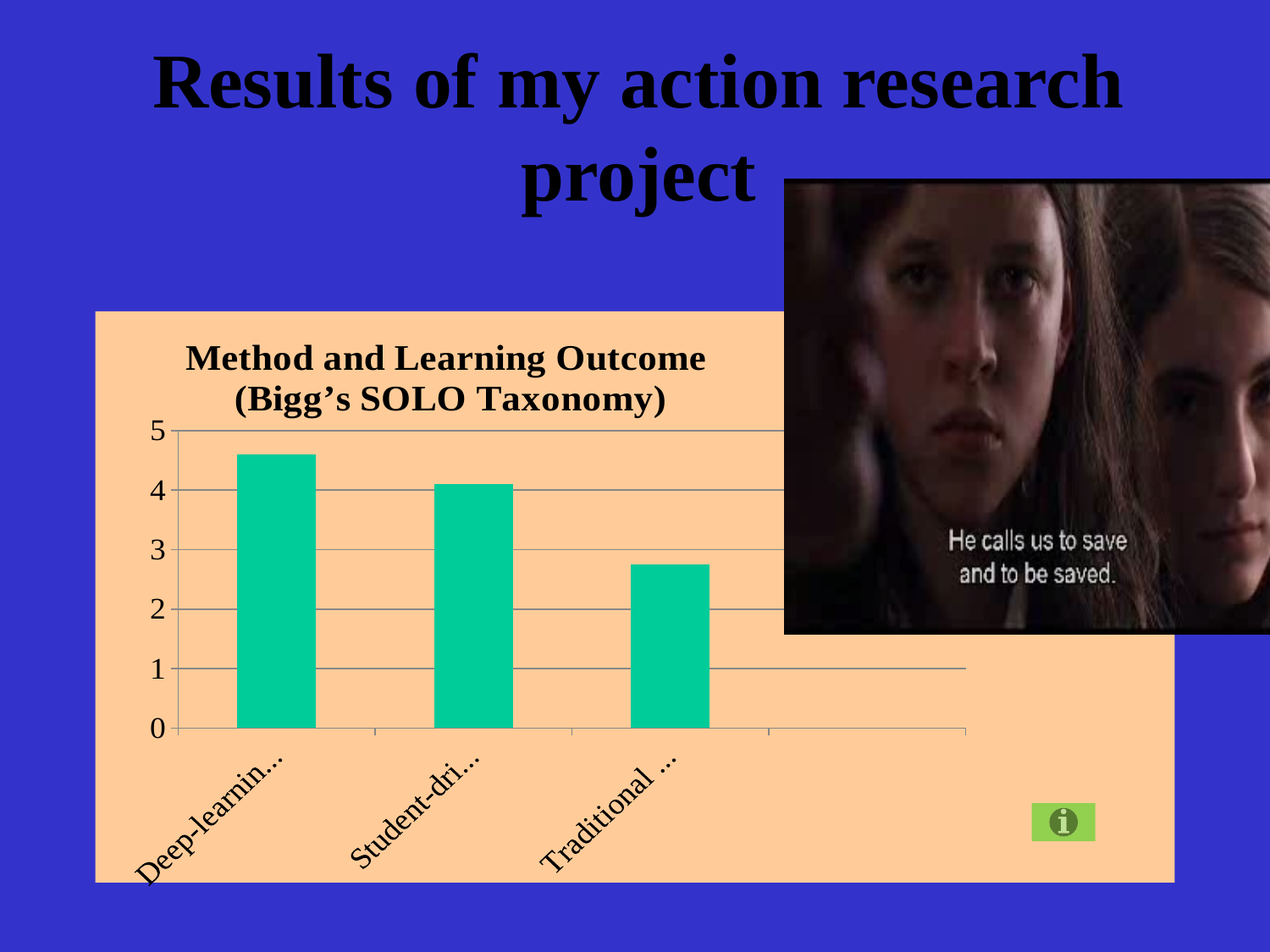
Which category has the highest bar? Deep-learnin... How many bars are plotted in the chart? 3 Which category has the lowest bar? Traditional ... Is the value for Traditional ... greater or less than 3? less What is the highest value shown on the vertical axis? 5 What is the title of the chart? Method and Learning Outcome (Bigg's SOLO Taxonomy) What kind of chart is shown on the slide? bar chart Is the value for Traditional ... greater or less than 2? greater Is the value for Student-dri... greater or less than 5? less Do the bar values rise or fall from left to right across the categories? fall Which is larger, the value for Deep-learnin... or the value for Traditional ...? Deep-learnin...